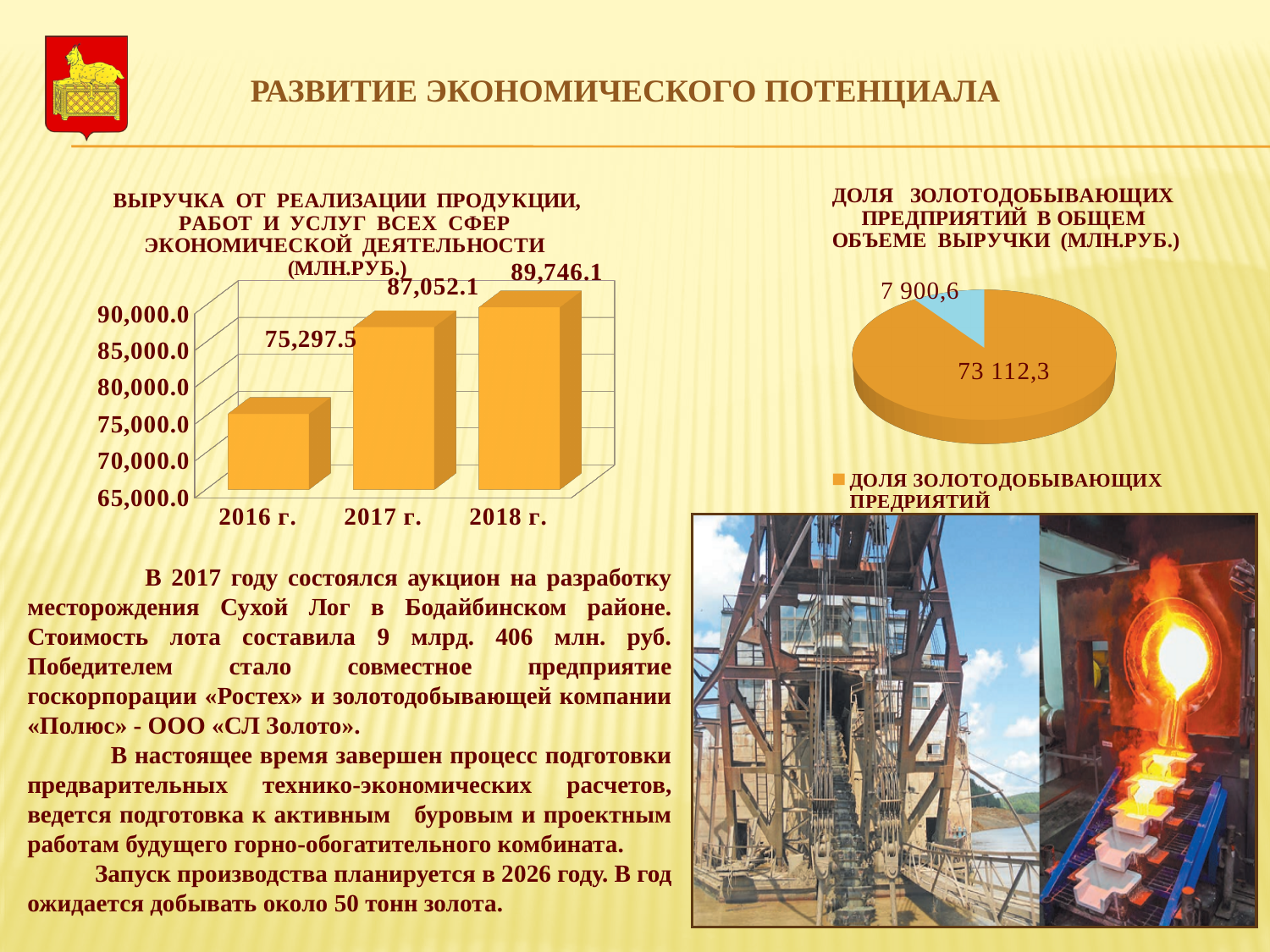
In the bar chart on the left, which year has the lowest value? 2016 г. In the bar chart on the left, what is the value for 2016 г.? 75,297.5 What type of chart is the chart on the right of the slide? pie chart In the bar chart on the left, how many years are shown? 3 In the bar chart on the left, what is the value for 2018 г.? 89,746.1 In the pie chart on the right, what is the value of the smaller (blue) slice? 7 900,6 In the bar chart on the left, what is the difference between the values for 2017 г. and 2016 г.? 11,754.6 In the bar chart on the left, what is the value for 2017 г.? 87,052.1 What type of chart is the chart on the left of the slide? bar chart In the bar chart on the left, do the values rise or fall from 2016 г. to 2018 г.? rise In the pie chart on the right, what is the value of the larger (orange) slice? 73 112,3 In the bar chart on the left, which year has the highest value? 2018 г.